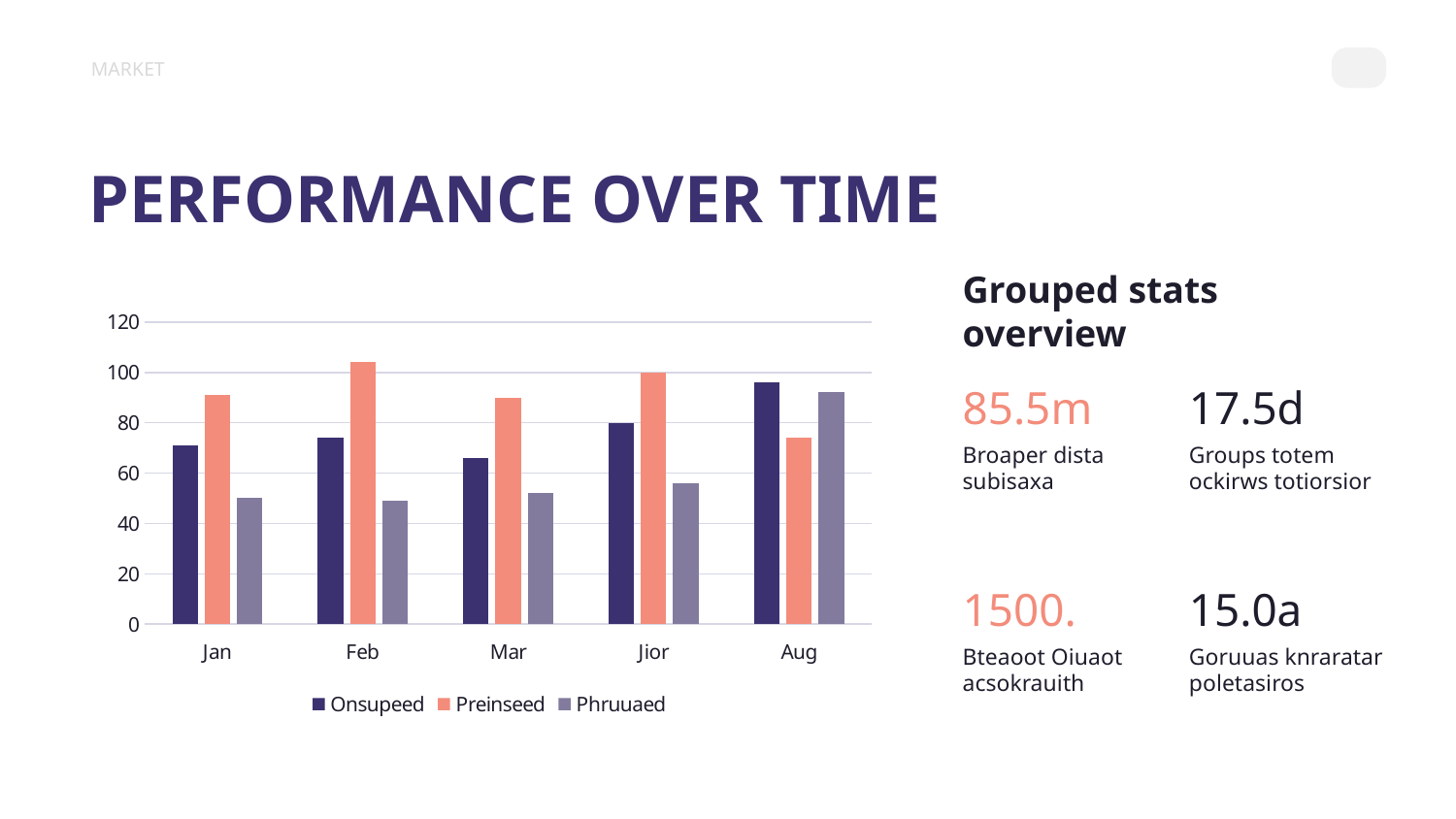
Is the Preinseed value for Feb greater or less than 100? greater How many categories are shown on the x axis of the chart? 5 How many series does the chart legend list? 3 In which month is the Preinseed value highest? Feb In Jan, which is larger: Onsupeed or Preinseed? Preinseed In which month is the Onsupeed value lowest? Mar In which month is the Onsupeed value highest? Aug Is the Phruuaed value for Jan greater or less than 60? less In which month is the Phruuaed value highest? Aug In Aug, which is larger: Onsupeed or Preinseed? Onsupeed What kind of chart is shown on the slide? bar chart Which series is shown in the orange/salmon colour in the chart legend? Preinseed